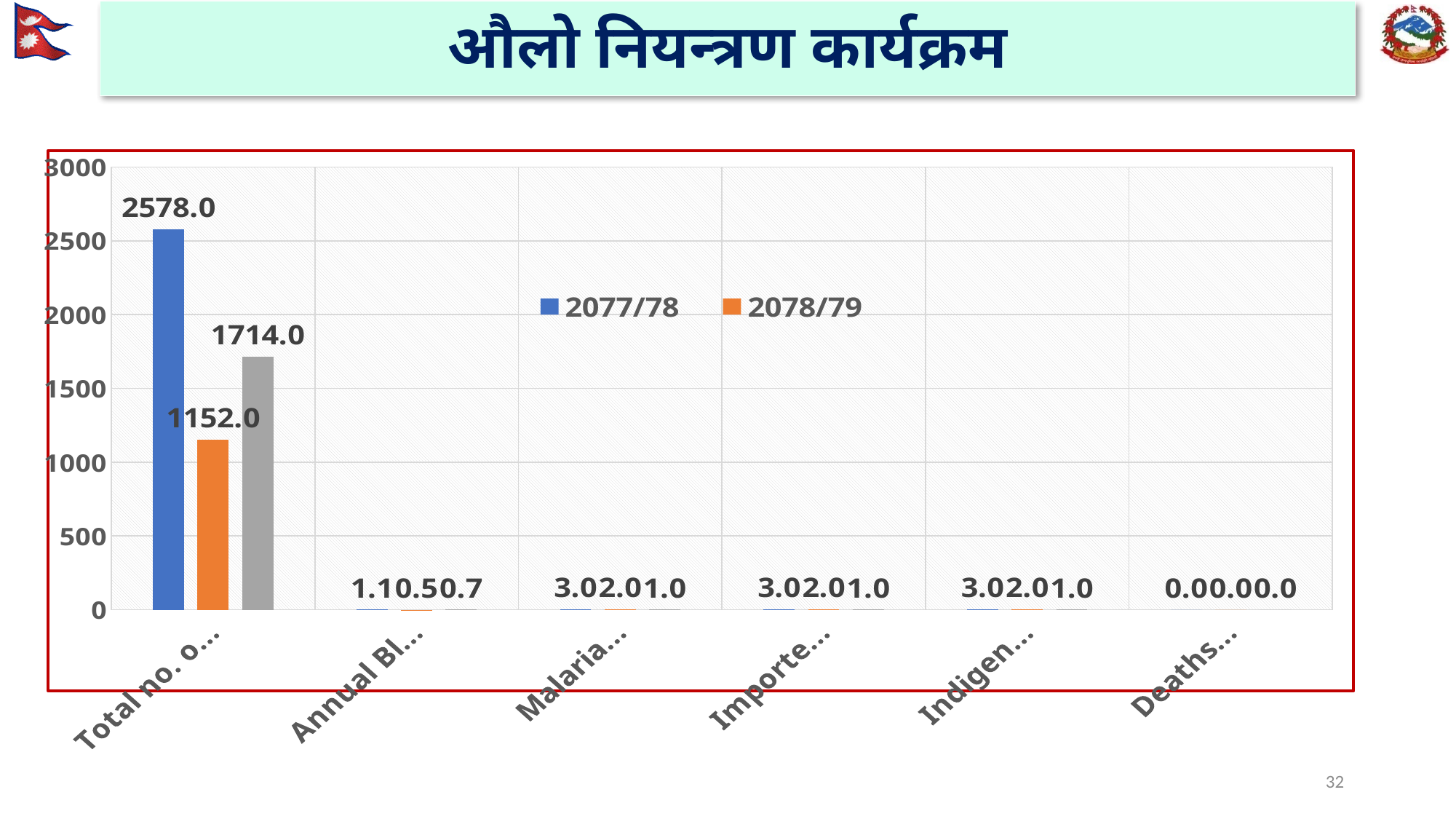
What is the value of the 2077/78 bar in the first (leftmost) category? 2578.0 What is the value of the gray bar in the first (leftmost) category? 1714.0 How many categories are shown along the x axis of the chart? 6 What is the difference between the 2077/78 bar and the gray bar in the first (leftmost) category? 864.0 What is the difference between the 2077/78 and 2078/79 values in the first (leftmost) category? 1426.0 How many series does the chart legend list? 2 What colour is used for the 2078/79 series in the legend? orange Is the value of the 2078/79 bar in the first (leftmost) category greater or less than 1500? less Which of the three bars in the first (leftmost) category is the lowest? 2078/79 What is the value of the 2078/79 bar in the first (leftmost) category? 1152.0 In the first (leftmost) category, which series has the larger value, 2077/78 or 2078/79? 2077/78 What kind of chart is shown on the slide? bar chart